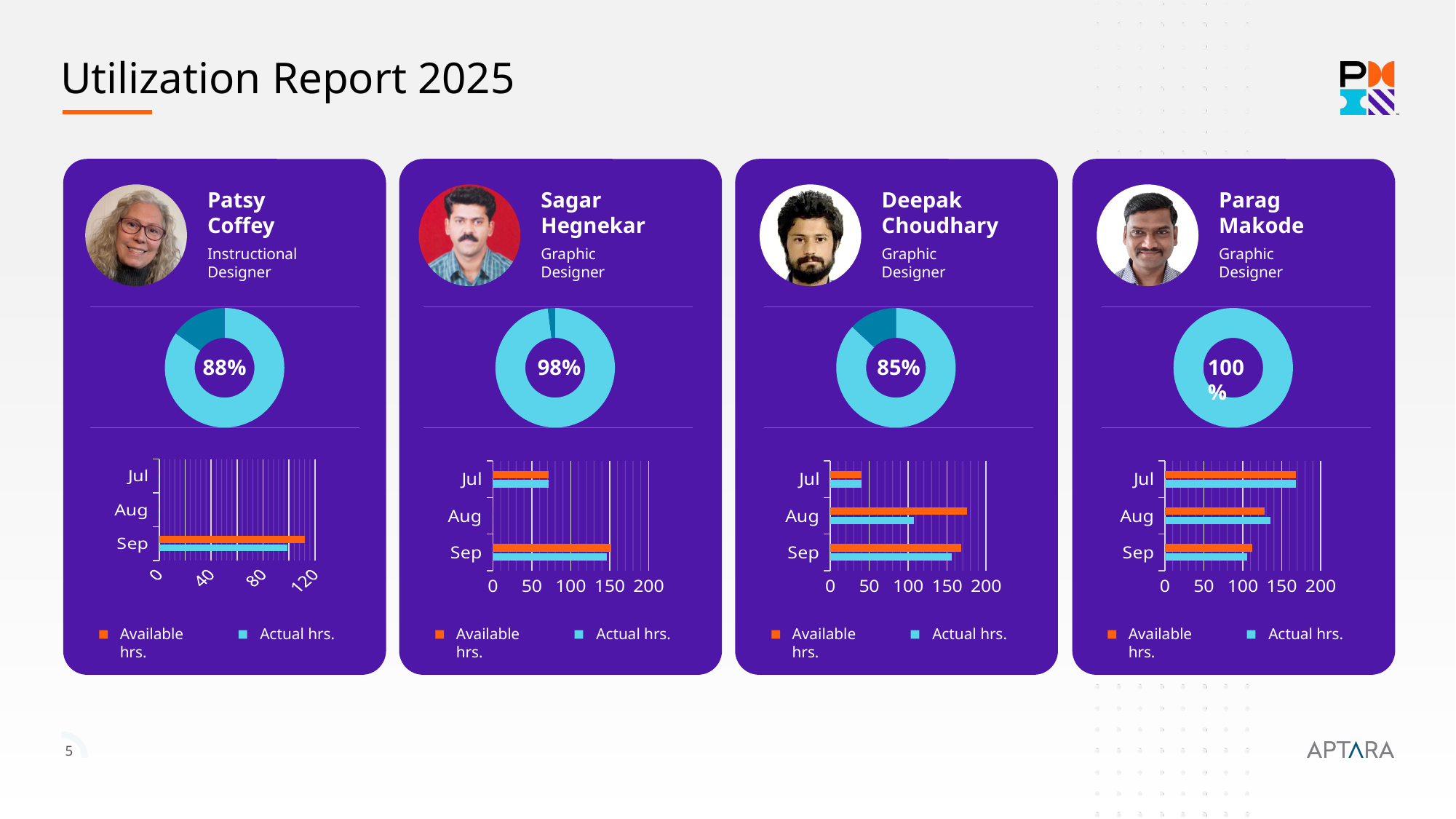
On Deepak Choudhary's card, what percentage is shown in the centre of the donut chart? 85% How many series does the legend list on Deepak Choudhary's bar chart? 2 Across the four donut charts, which person has the highest utilization percentage? Parag Makode Across the four donut charts, which person has the lowest utilization percentage? Deepak Choudhary What is the difference between Sagar Hegnekar's donut percentage and Deepak Choudhary's donut percentage? 13% What kind of chart is shown at the bottom of each card, below the donut chart? Bar chart On Deepak Choudhary's bar chart, is the Available hrs. value for Aug greater or less than 150? greater On Parag Makode's card, what percentage is shown in the centre of the donut chart? 100% On Patsy Coffey's card, what percentage is shown in the centre of the donut chart? 88% On Sagar Hegnekar's card, what percentage is shown in the centre of the donut chart? 98% How many months are shown on the y axis of Sagar Hegnekar's bar chart? 3 On Deepak Choudhary's bar chart, which is larger for Aug: Available hrs. or Actual hrs.? Available hrs.